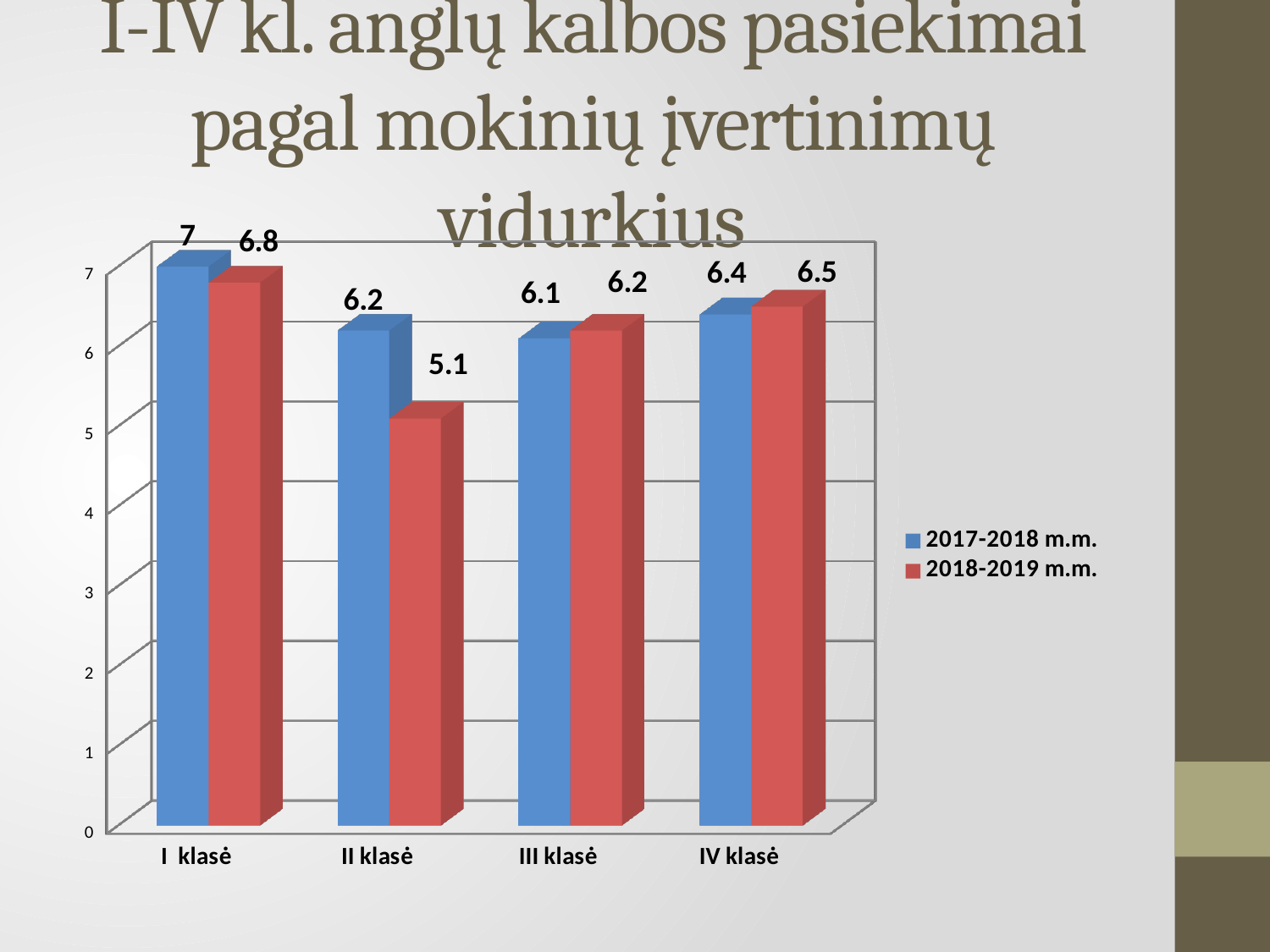
Is the value for II klasė in the 2018-2019 m.m. series greater or less than 6? less How many series does the legend list? 2 What kind of chart is shown on the slide? bar chart Which class has the lowest value in the 2018-2019 m.m. series? II klasė For III klasė, which series has the larger value: 2017-2018 m.m. or 2018-2019 m.m.? 2018-2019 m.m. What is the difference between the 2017-2018 m.m. and 2018-2019 m.m. values for II klasė? 1.1 What is the value for I klasė in the 2017-2018 m.m. series? 7 Which colour represents the 2018-2019 m.m. series? red Which class has the highest value in the 2017-2018 m.m. series? I klasė How many classes are shown on the x axis? 4 What is the value for IV klasė in the 2018-2019 m.m. series? 6.5 What is the value for II klasė in the 2018-2019 m.m. series? 5.1